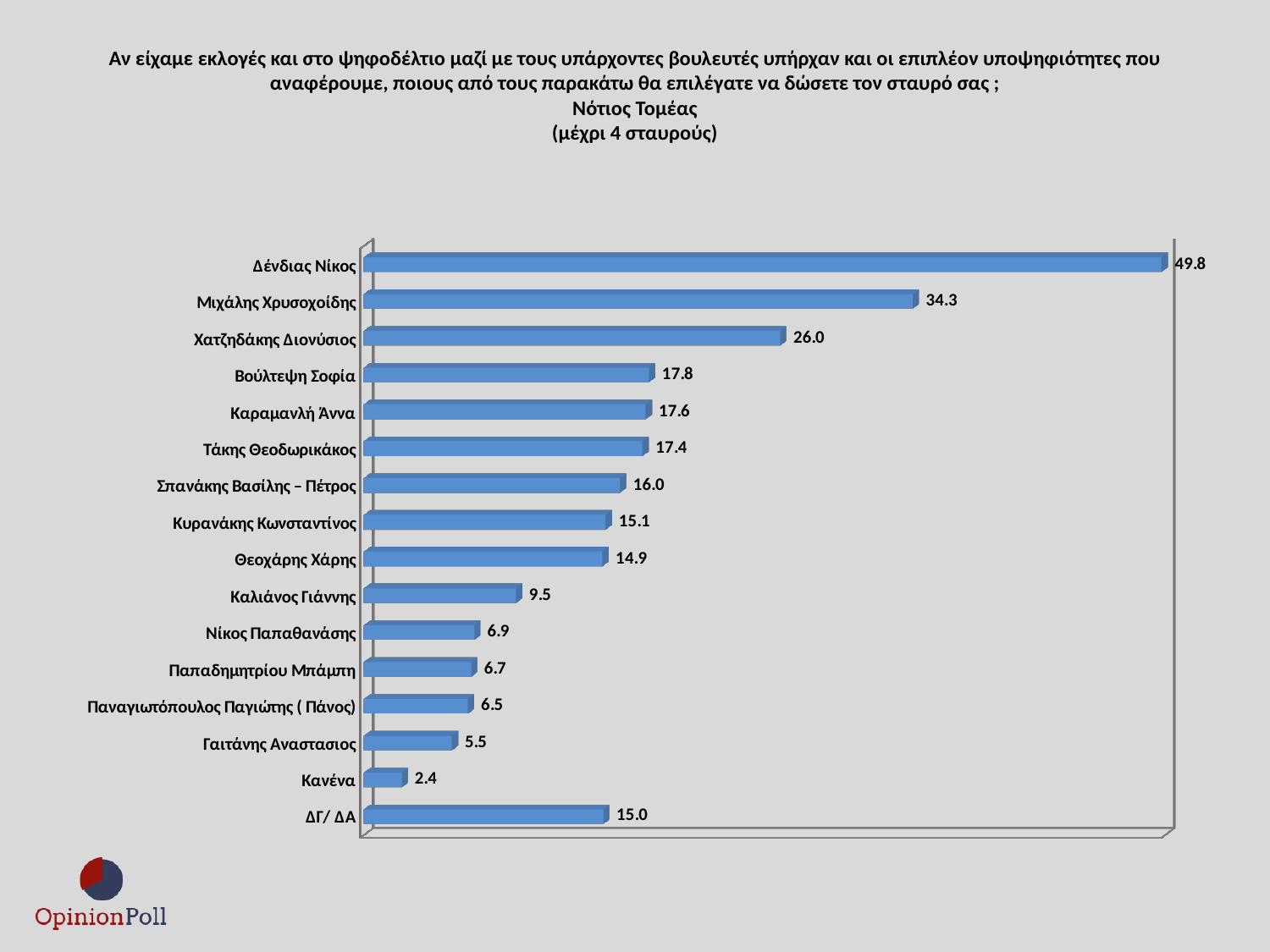
Which is larger, the value for Κυρανάκης Κωνσταντίνος or the value for Γαιτάνης Αναστάσιος? Κυρανάκης Κωνσταντίνος What value is shown for ΔΓ/ ΔΑ? 15.0 What kind of chart is shown on the slide? Bar chart What is the difference between the values for Δένδιας Νίκος and Μιχάλης Χρυσοχοΐδης? 15.5 Which category has the lowest value? Κανένα How many categories are shown in the chart? 16 What is the difference between the values for Βούλτεψη Σοφία and Τάκης Θεοδωρικάκος? 0.4 Which is larger, the value for Μιχάλης Χρυσοχοΐδης or the value for Χατζηδάκης Διονύσιος? Μιχάλης Χρυσοχοΐδης What value is shown for Καλιάνος Γιάννης? 9.5 What value is shown for Χατζηδάκης Διονύσιος? 26.0 Which category has the highest value? Δένδιας Νίκος What value is shown for Δένδιας Νίκος? 49.8